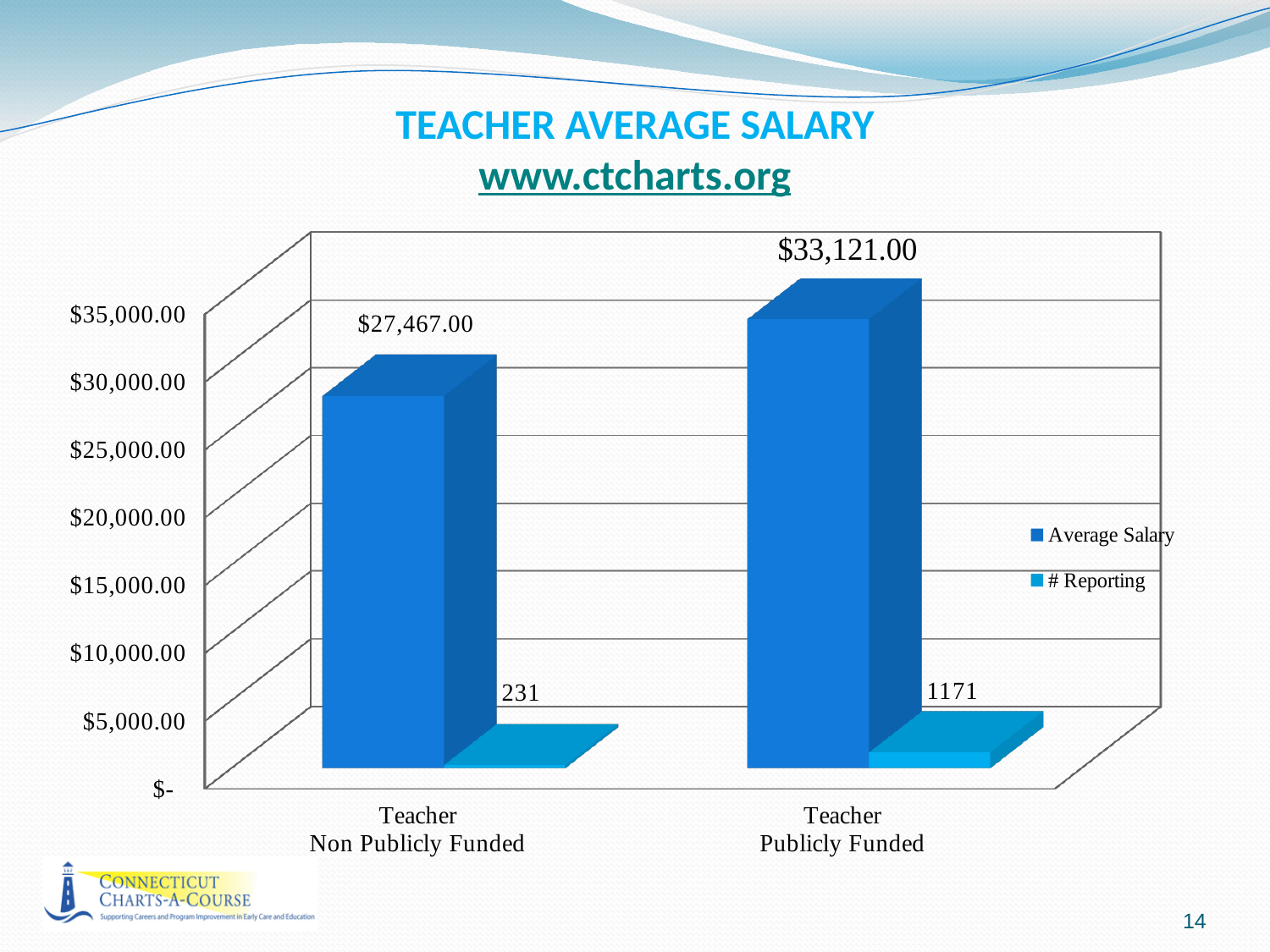
How many series does the legend list? 2 Which category has the lower # Reporting value? Teacher Non Publicly Funded What is the # Reporting value for Teacher Publicly Funded? 1171 Which category has the higher Average Salary? Teacher Publicly Funded What is the # Reporting value for Teacher Non Publicly Funded? 231 What is the difference in Average Salary between Teacher Publicly Funded and Teacher Non Publicly Funded? $5,654.00 Is the Average Salary for Teacher Non Publicly Funded greater or less than $30,000.00? less What is the Average Salary for Teacher Publicly Funded? $33,121.00 What is the difference in # Reporting between Teacher Publicly Funded and Teacher Non Publicly Funded? 940 What is the Average Salary for Teacher Non Publicly Funded? $27,467.00 What kind of chart is shown on the slide? bar chart How many categories are shown on the x axis? 2